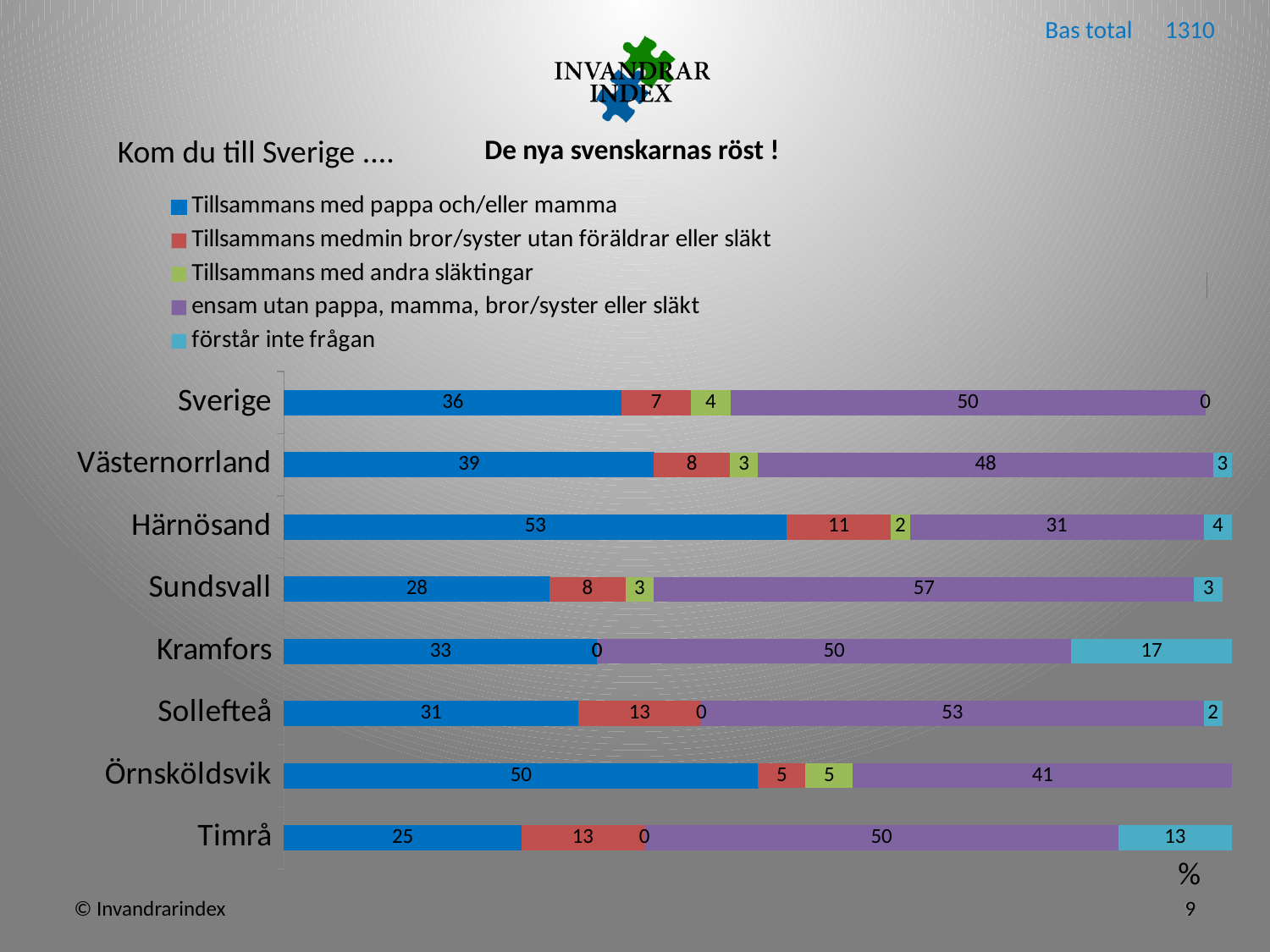
What is the value for 'Tillsammans med pappa och/eller mamma' for Härnösand? 53 How many categories (regions) are shown on the chart? 8 What is the value for 'ensam utan pappa, mamma, bror/syster eller släkt' for Sundsvall? 57 What kind of chart is shown on the slide? stacked bar chart What is the value for 'förstår inte frågan' for Kramfors? 17 What is the difference between the 'ensam utan pappa, mamma, bror/syster eller släkt' values for Sundsvall and Härnösand? 26 Which region has the highest value for 'Tillsammans med pappa och/eller mamma'? Härnösand Which is larger: the 'Tillsammans med pappa och/eller mamma' value for Sverige or for Västernorrland? Västernorrland Which region has the lowest value for 'Tillsammans med pappa och/eller mamma'? Timrå How many series does the legend list? 5 What is the value for 'Tillsammans medmin bror/syster utan föräldrar eller släkt' for Timrå? 13 What is the 'Bas total' shown on the slide? 1310